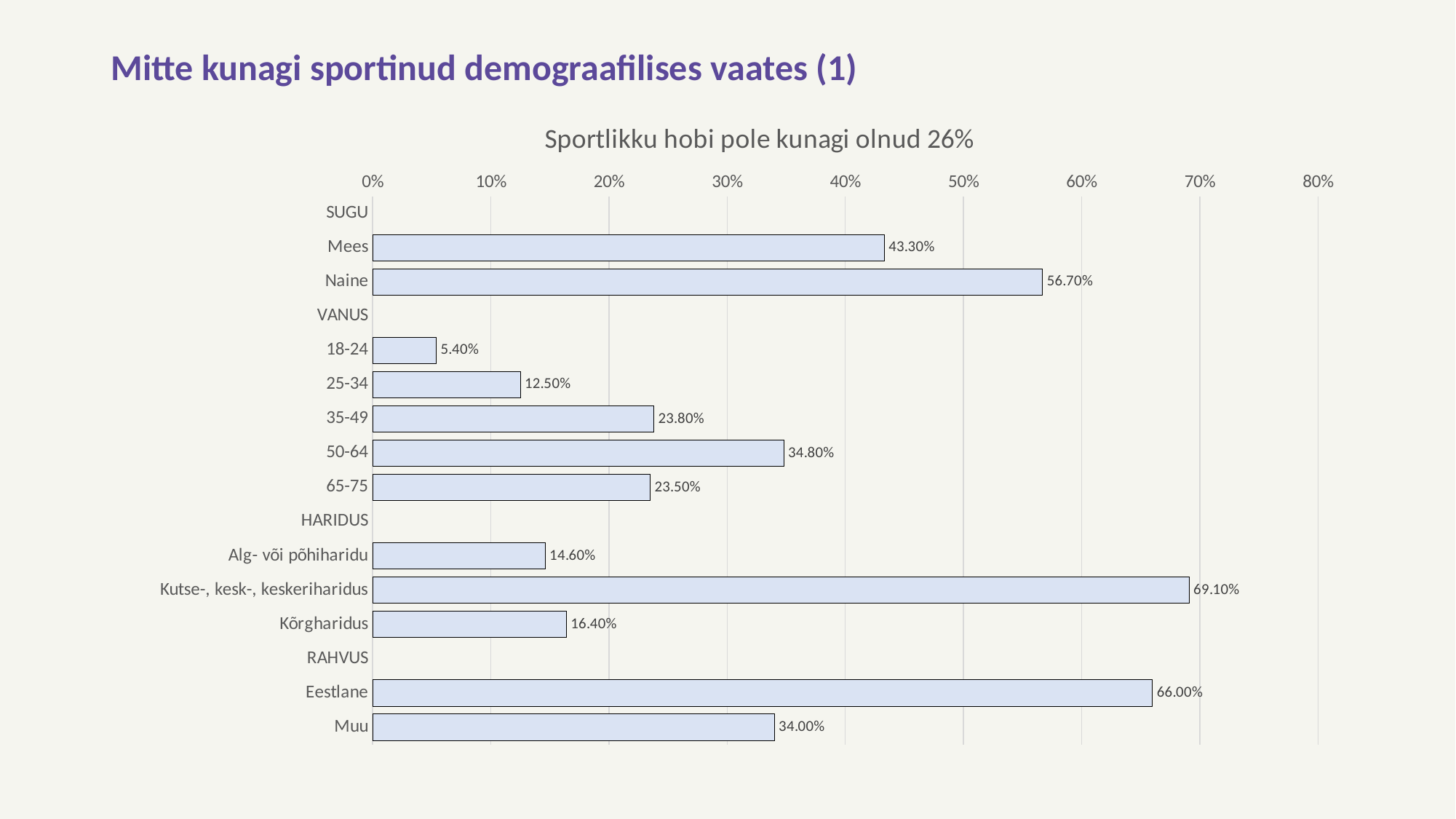
Which is larger, the value for 25-34 or the value for 35-49? 35-49 What is the value for Kõrgharidus? 16.40% What is the value for Muu? 34.00% What is the value for Naine? 56.70% What is the value for the 50-64 age group? 34.80% What kind of chart is shown on the slide? bar chart Is the value for Mees greater or less than 40%? greater What is the difference between the values for Naine and Mees? 13.40% What is the difference between the values for Eestlane and Muu? 32.00% Which category has the lowest value? 18-24 What is the title of the chart? Sportlikku hobi pole kunagi olnud 26% Which category has the highest value? Kutse-, kesk-, keskeriharidus